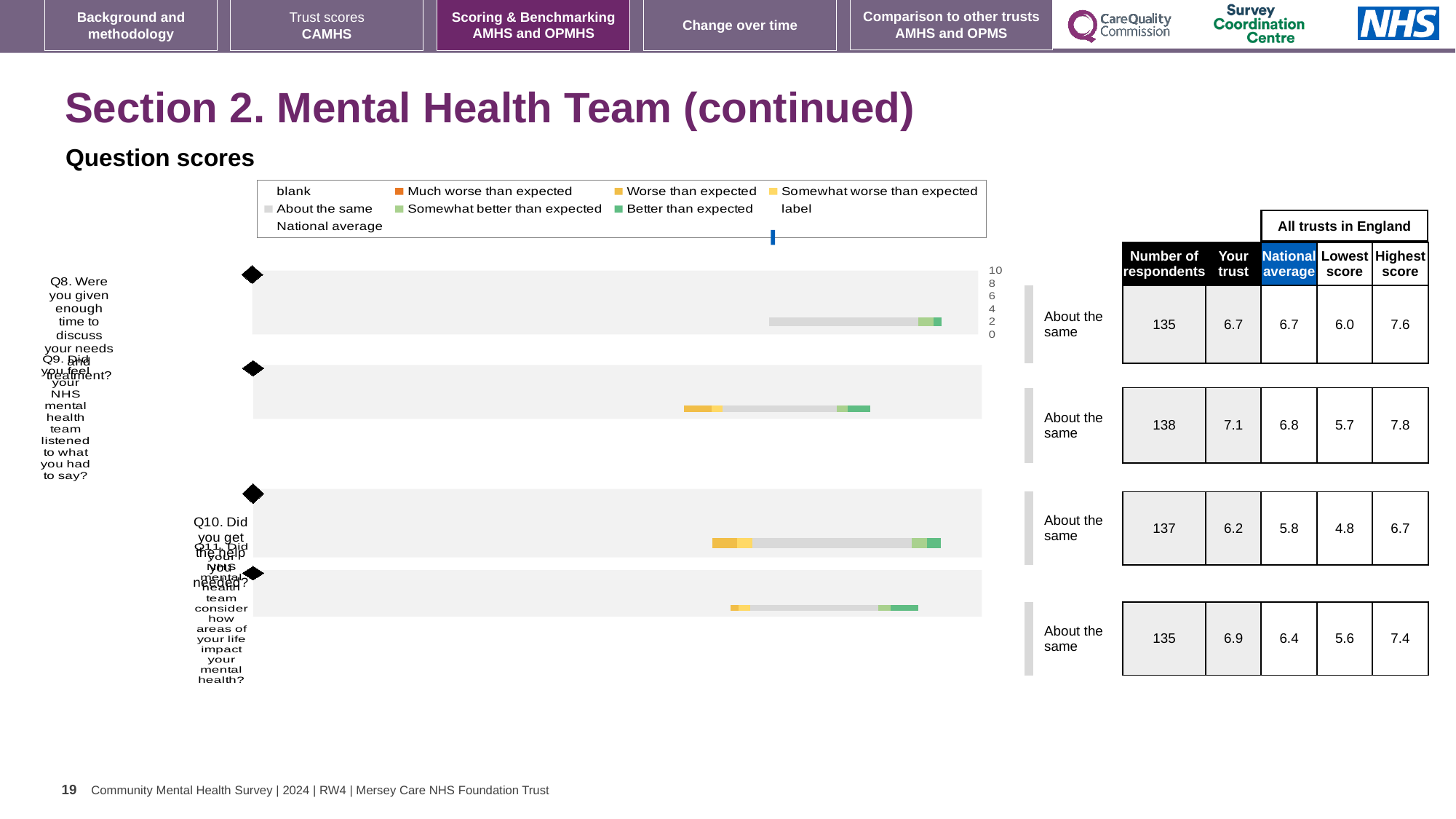
In the table beside the chart, what is the number of respondents for Q9? 138 For Q10, which is larger: the 'Your trust' score or the national average? Your trust In the table beside the chart, what is the national average for Q10? 5.8 In the legend of the question scores chart, what colour represents 'Much worse than expected'? orange Which question has the highest 'Your trust' score in the table beside the chart? Q9 How many questions (bars) are plotted in the question scores chart? 4 In the legend of the question scores chart, what colour represents 'Better than expected'? green In the table beside the chart, what is the 'Your trust' score for Q8? 6.7 What kind of chart is used to show the question scores on this slide? bar chart What is the difference between the 'Your trust' score and the national average for Q9? 0.3 In the table beside the chart, what is the highest score across all trusts in England for Q11? 7.4 Which question has the lowest 'Your trust' score in the table beside the chart? Q10